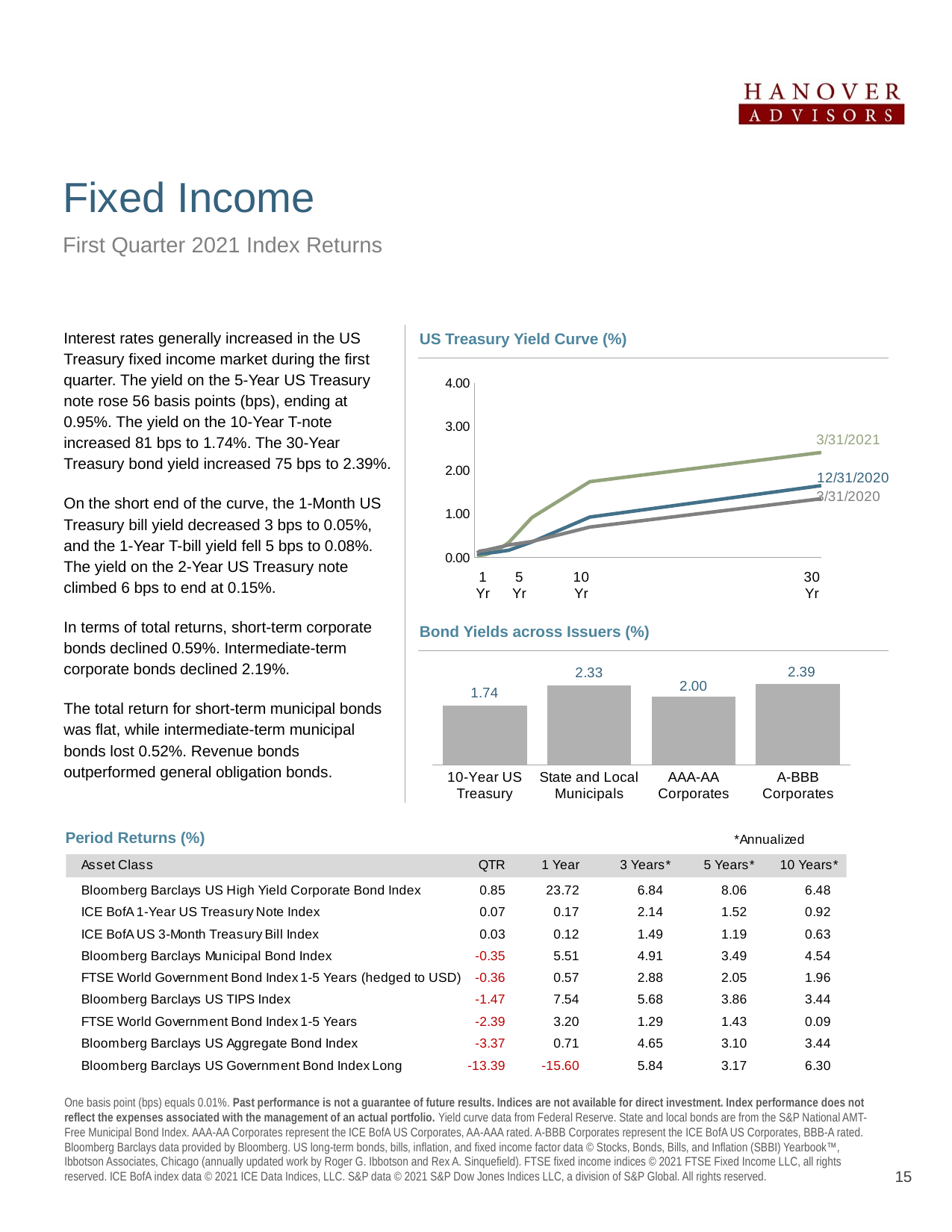
In the Bond Yields across Issuers (%) chart, what is the difference between A-BBB Corporates and 10-Year US Treasury? 0.65 In the US Treasury Yield Curve (%) chart, is the 3/31/2021 value at 30 Yr greater or less than 2.00? greater In the US Treasury Yield Curve (%) chart, do the 3/31/2021 values rise or fall from 1 Yr to 30 Yr? Rise In the Bond Yields across Issuers (%) chart, which is larger, State and Local Municipals or AAA-AA Corporates? State and Local Municipals How many series are shown in the US Treasury Yield Curve (%) chart? 3 How many categories are shown in the Bond Yields across Issuers (%) chart? 4 In the Bond Yields across Issuers (%) chart, which category has the highest value? A-BBB Corporates In the Bond Yields across Issuers (%) chart, what is the value for State and Local Municipals? 2.33 In the Bond Yields across Issuers (%) chart, which category has the lowest value? 10-Year US Treasury In the Bond Yields across Issuers (%) chart, what is the value for 10-Year US Treasury? 1.74 What kind of chart is the US Treasury Yield Curve (%) chart? Line chart In the Bond Yields across Issuers (%) chart, what is the value for AAA-AA Corporates? 2.00